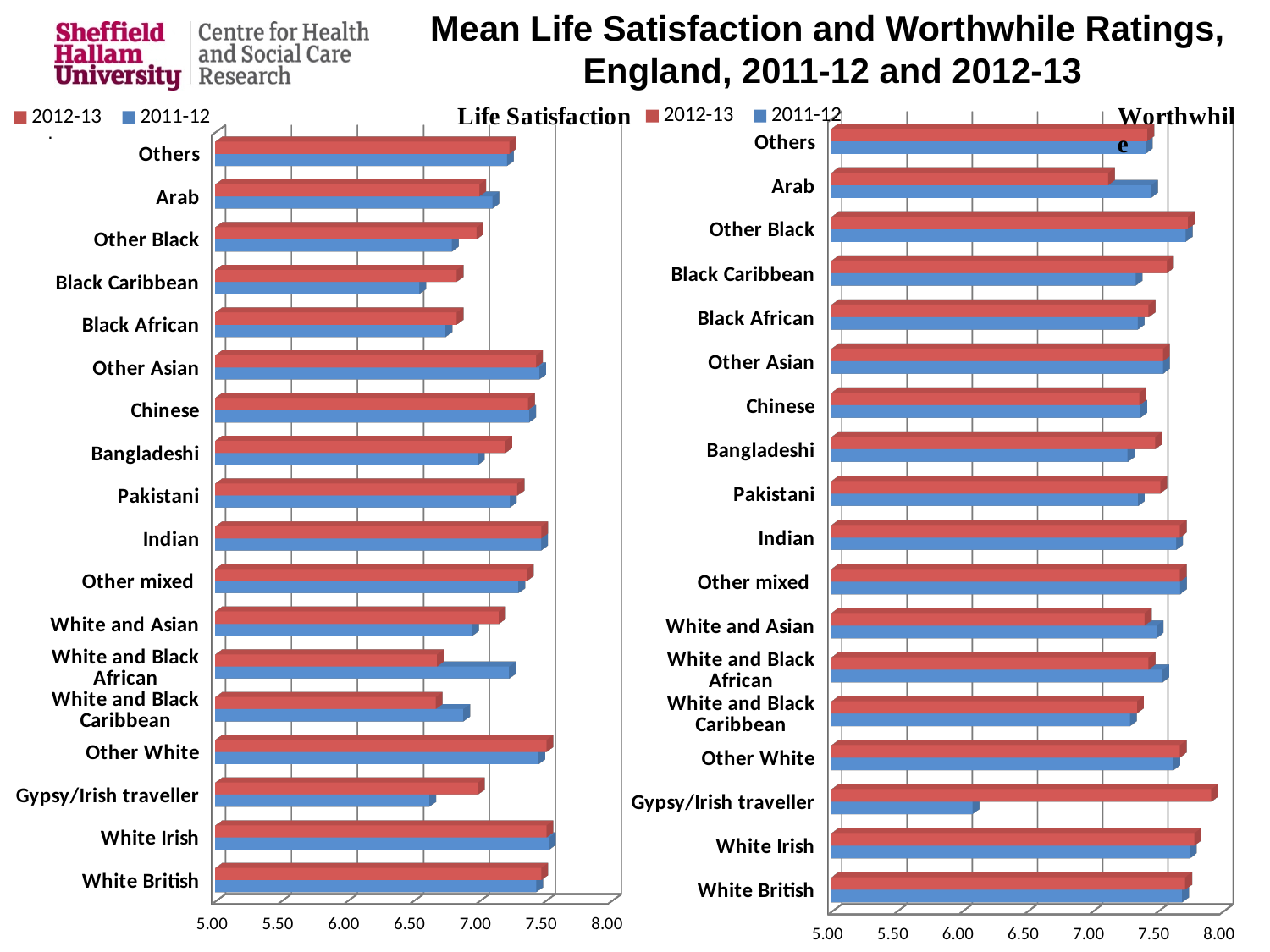
In the Worthwhile chart, which category has the lowest 2011-12 value? Gypsy/Irish traveller In the Worthwhile chart, which year has the larger value for Arab, 2011-12 or 2012-13? 2011-12 In the Life Satisfaction chart, is the 2011-12 value for Gypsy/Irish traveller greater or less than 7.00? less How many ethnic group categories are shown on the Life Satisfaction chart? 18 What kind of chart is the Life Satisfaction chart on the left? bar chart In the Worthwhile chart, is the 2011-12 value for Gypsy/Irish traveller greater or less than 6.50? less In the Worthwhile chart, is the 2012-13 value for Arab greater or less than 7.00? greater How many series does the legend of the Worthwhile chart list? 2 In the Worthwhile chart, which year has the larger value for Gypsy/Irish traveller, 2011-12 or 2012-13? 2012-13 In the Life Satisfaction chart, which year has the larger value for White and Black African, 2011-12 or 2012-13? 2011-12 Which colour represents the 2012-13 series in the charts? red